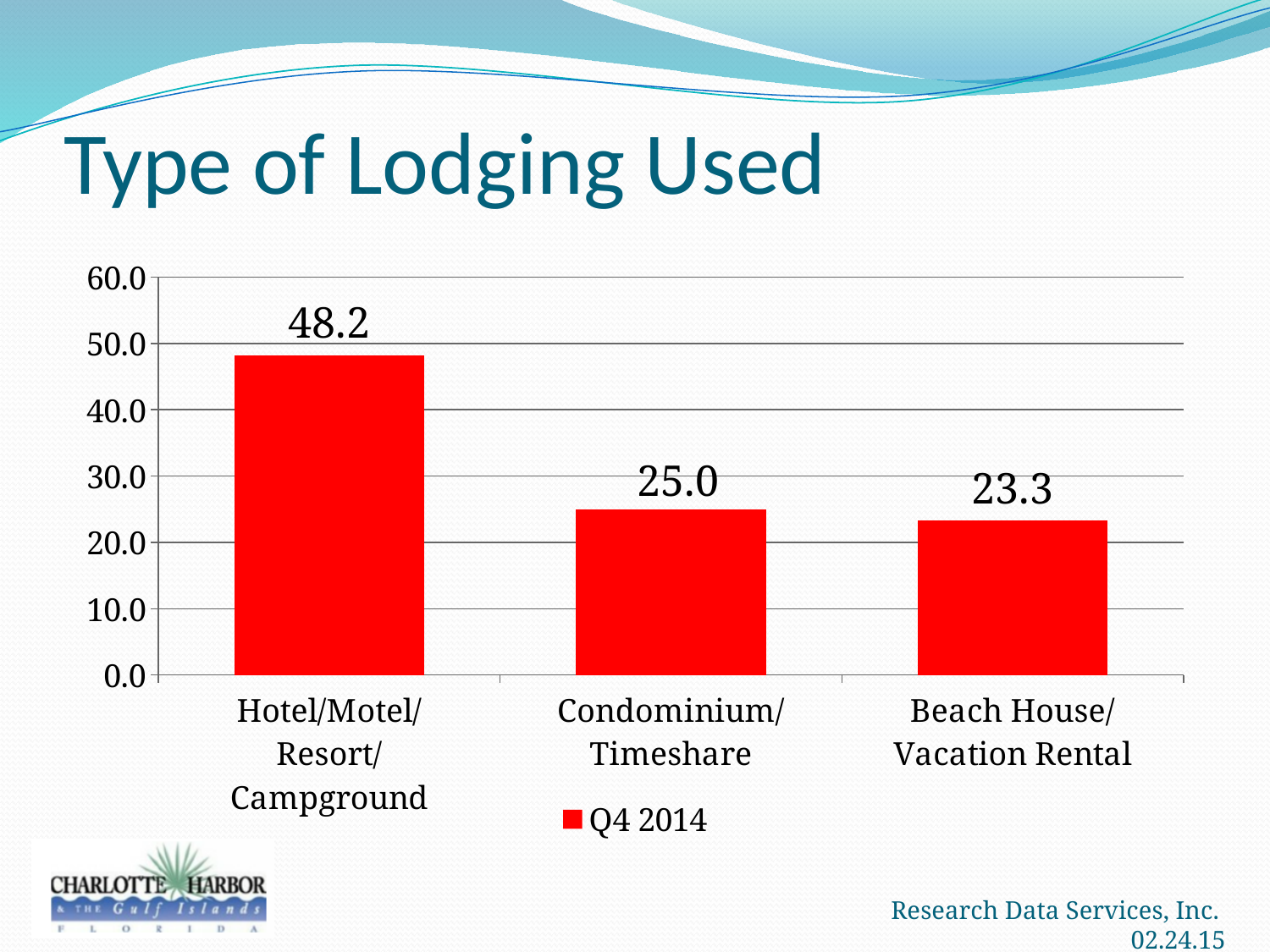
Which lodging type has the highest value? Hotel/Motel/Resort/Campground What kind of chart is shown on the slide? bar chart Which is larger, the value for Condominium/Timeshare or Beach House/Vacation Rental? Condominium/Timeshare Is the value for Hotel/Motel/Resort/Campground greater or less than 40.0? greater What is the difference between the values for Condominium/Timeshare and Beach House/Vacation Rental? 1.7 What is the difference between the values for Hotel/Motel/Resort/Campground and Condominium/Timeshare? 23.2 What is the value for Condominium/Timeshare? 25.0 Which lodging type has the lowest value? Beach House/Vacation Rental What is the value for Beach House/Vacation Rental? 23.3 What is the value for Hotel/Motel/Resort/Campground? 48.2 What series does the legend list? Q4 2014 How many lodging categories are shown in the chart? 3